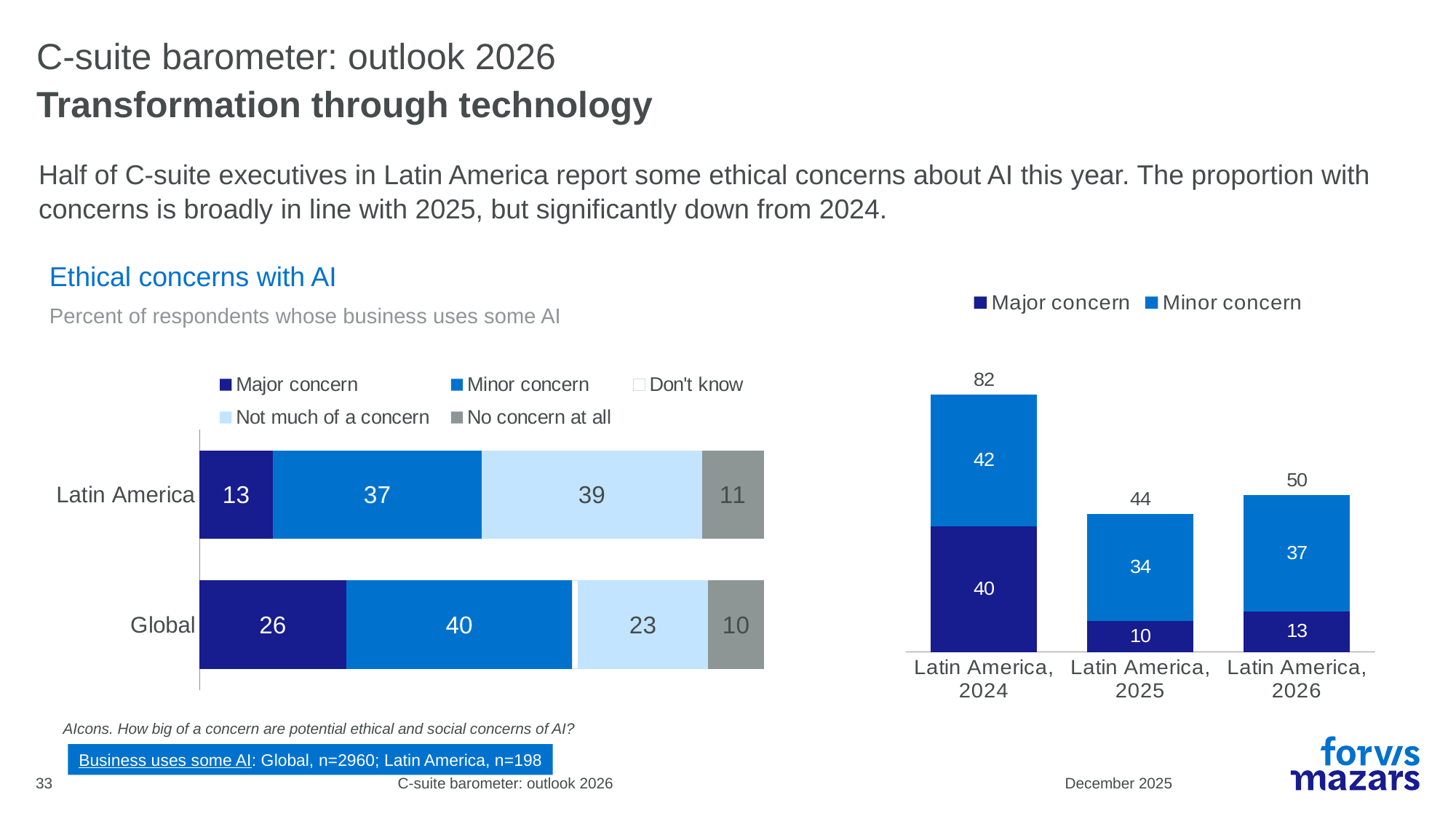
In the left chart titled 'Ethical concerns with AI', what is the value for 'Not much of a concern' for Global? 23 In the left chart titled 'Ethical concerns with AI', how many series does the legend list? 5 In the left chart titled 'Ethical concerns with AI', how many categories are shown on the vertical axis? 2 What kind of chart is the chart on the right of the slide? Stacked bar chart In the right chart, what is the 'Minor concern' value for Latin America, 2025? 34 In the left chart titled 'Ethical concerns with AI', which has the larger 'Minor concern' value, Latin America or Global? Global In the right chart, what is the total of the stacked bar for Latin America, 2024? 82 In the left chart titled 'Ethical concerns with AI', what is the value for 'Major concern' for Latin America? 13 In the left chart titled 'Ethical concerns with AI', what is the difference between the 'Major concern' values for Global and Latin America? 13 In the right chart, what is the difference between the bar totals for Latin America, 2024 and Latin America, 2026? 32 In the right chart, which year has the lowest 'Major concern' value for Latin America? Latin America, 2025 In the left chart titled 'Ethical concerns with AI', what is the subtitle shown below the chart title? Percent of respondents whose business uses some AI